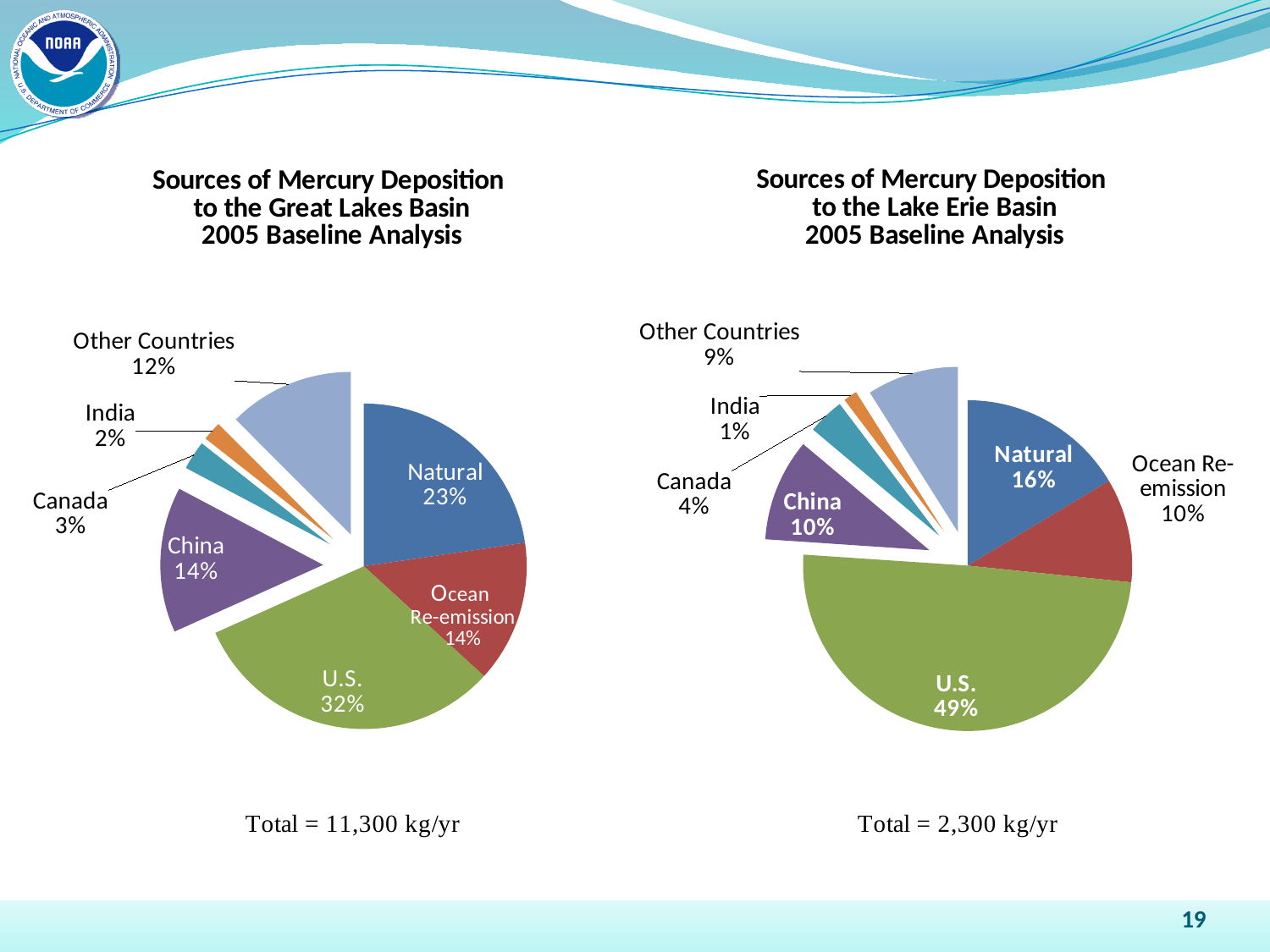
How many slices does the Lake Erie Basin pie chart have? 7 In the Lake Erie Basin chart, what percentage is attributed to China? 10% In the Lake Erie Basin chart, what share of mercury deposition comes from the U.S.? 49% In the Great Lakes Basin chart, what is the difference between the U.S. share and the China share? 18% What type of chart is used for the Great Lakes Basin data? Pie chart In the Great Lakes Basin chart, what share of mercury deposition comes from the U.S.? 32% What total annual mercury deposition is stated below the Lake Erie Basin chart? 2,300 kg/yr In the Great Lakes Basin chart, which source has the smallest share? India In the Great Lakes Basin chart, what percentage is attributed to Natural sources? 23% In the Lake Erie Basin chart, which source has the smallest share? India In the Great Lakes Basin chart, which source has the largest share? U.S. In the Lake Erie Basin chart, which is larger, the share for Natural or the share for Ocean Re-emission? Natural